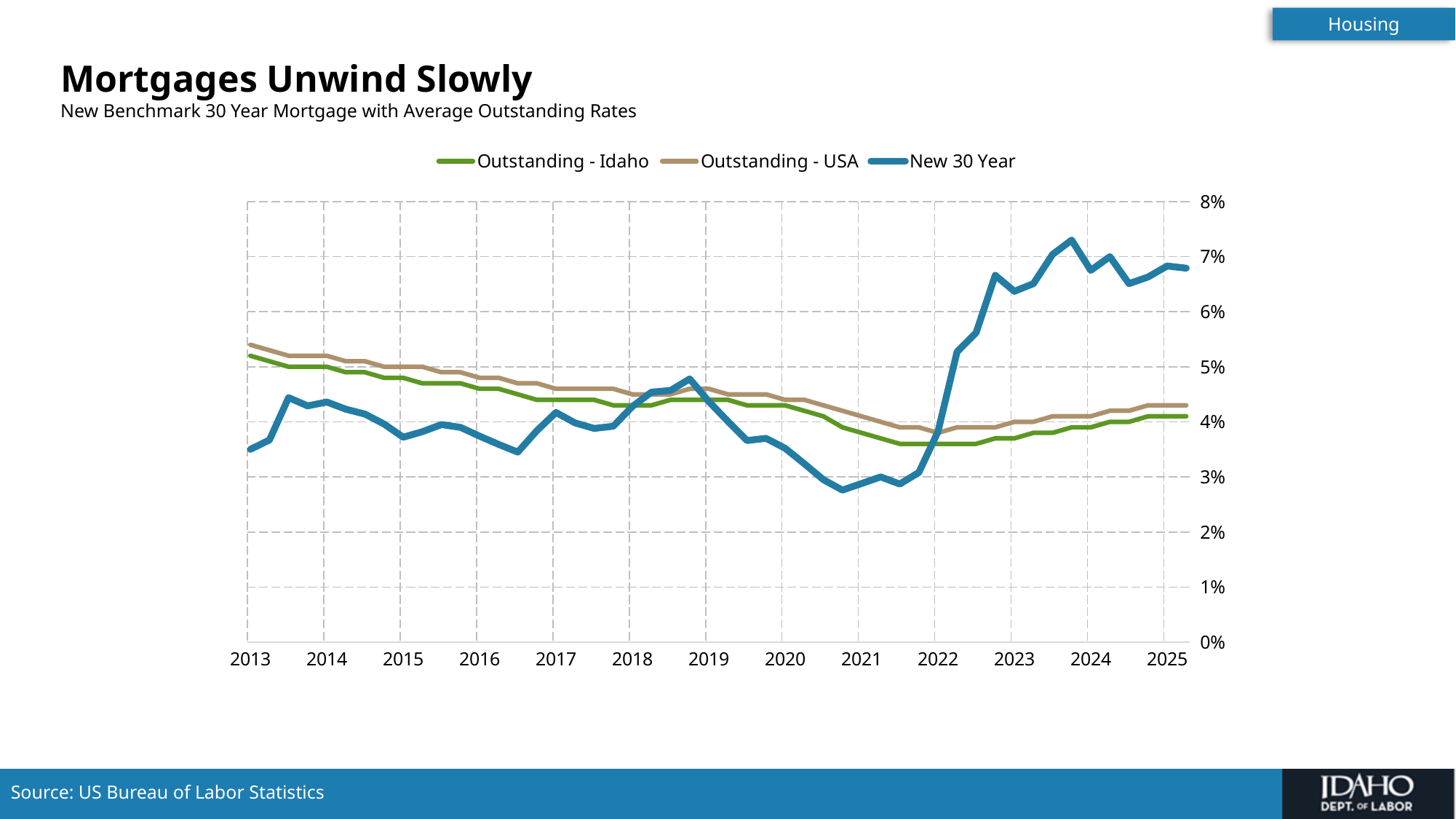
Is the value for Outstanding - Idaho at 2025 greater or less than 5%? less At 2013, which series is higher: Outstanding - USA or Outstanding - Idaho? Outstanding - USA Is the value for Outstanding - USA at 2013 greater or less than 5%? greater Is the value for New 30 Year at 2024 greater or less than 6%? greater Does the Outstanding - Idaho line rise or fall from 2013 to 2021? fall What is the subtitle printed under the chart title 'Mortgages Unwind Slowly'? New Benchmark 30 Year Mortgage with Average Outstanding Rates What are the three series named in the legend? Outstanding - Idaho, Outstanding - USA, New 30 Year What kind of chart is shown on the slide? line chart At 2025, which series is higher: New 30 Year or Outstanding - Idaho? New 30 Year How many series does the legend list? 3 Does the New 30 Year line rise or fall from 2021 to 2023? rise